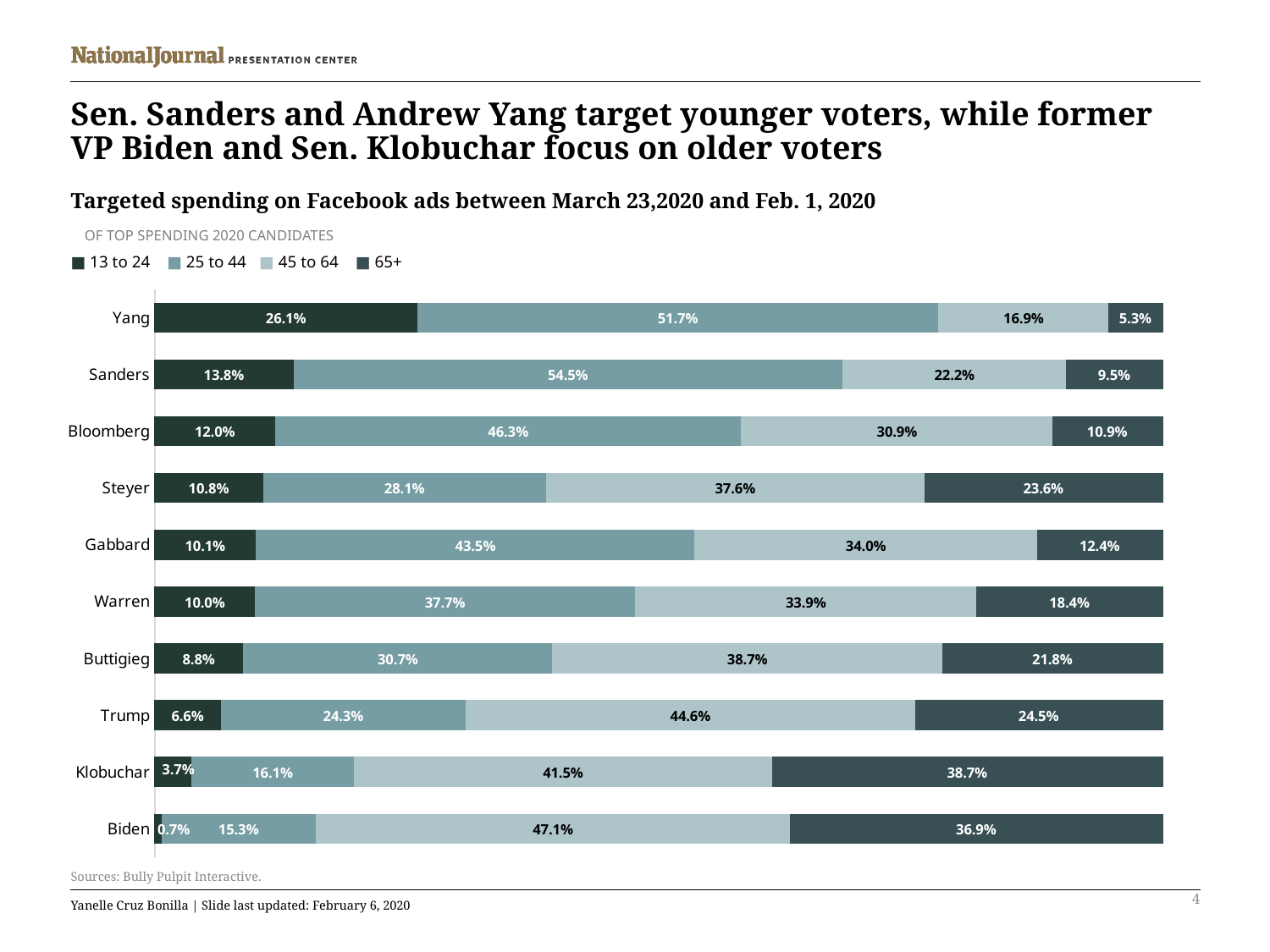
Which is larger: Steyer's 45 to 64 share or Buttigieg's 45 to 64 share? Buttigieg's 45 to 64 share What is the difference between Klobuchar's and Biden's 65+ shares? 1.8 percentage points How many candidates are shown in the chart? 10 What share of Trump's targeted Facebook ad spending went to the 45 to 64 age group? 44.6% What share of Biden's targeted Facebook ad spending went to the 65+ age group? 36.9% How many age groups does the legend list? 4 What share of Sanders' targeted Facebook ad spending went to the 25 to 44 age group? 54.5% Which candidate has the highest share of spending targeted at the 13 to 24 age group? Yang What share of Yang's targeted Facebook ad spending went to the 13 to 24 age group? 26.1% Which candidate has the lowest share of spending targeted at the 13 to 24 age group? Biden What type of chart is shown on the slide? Stacked bar chart Which candidate has the highest share of spending targeted at the 65+ age group? Klobuchar